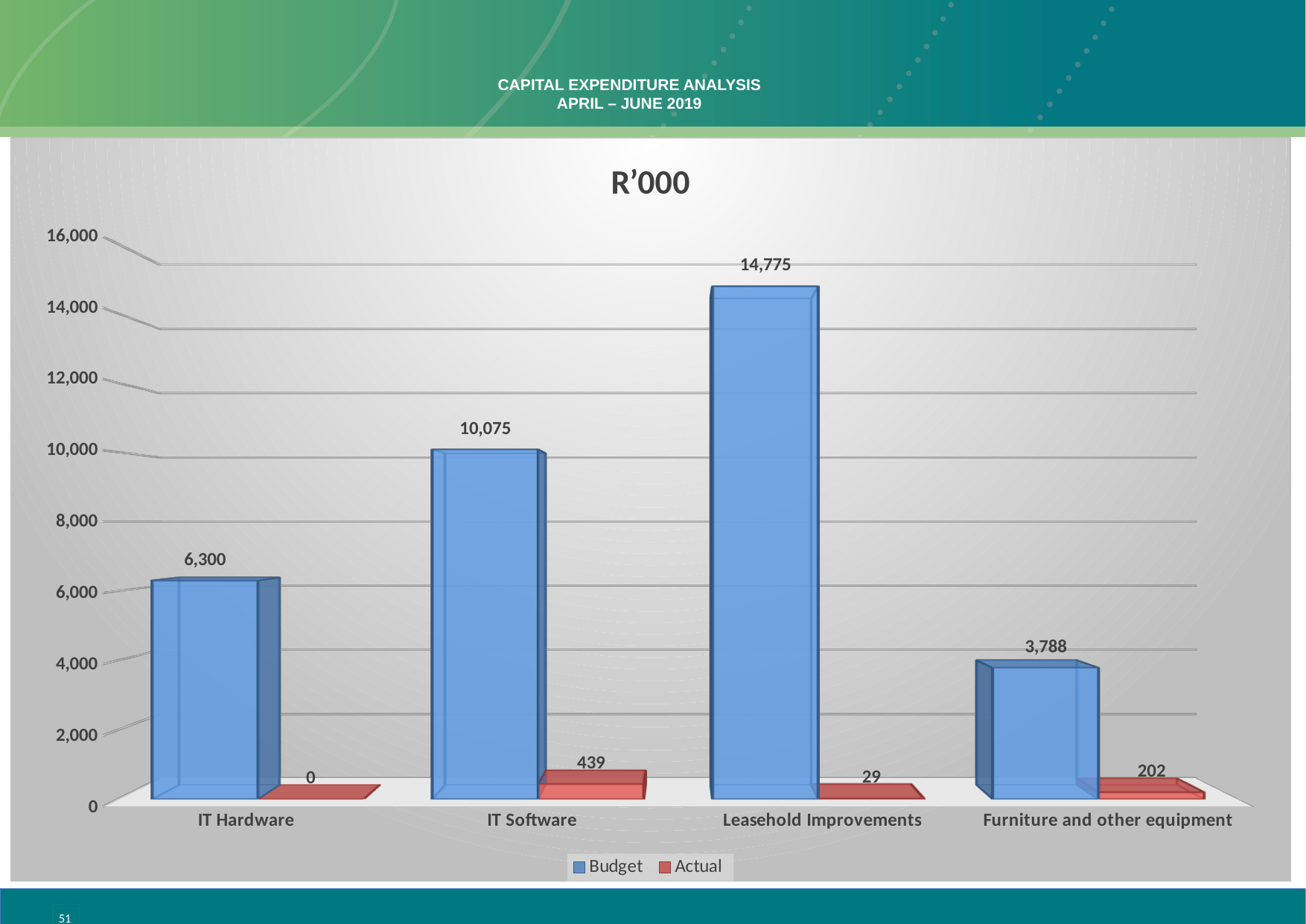
What is the difference between the Budget and Actual values for Leasehold Improvements? 14,746 How many series does the legend list? 2 What is the Actual value for IT Hardware? 0 Is the Budget value for IT Software greater or less than 8,000? greater What is the Budget value for IT Software? 10,075 Which category has the lowest Budget value? Furniture and other equipment How many categories are shown on the x axis? 4 What type of chart is shown on the slide? Bar chart Which is larger, the Budget value for IT Hardware or the Budget value for Furniture and other equipment? IT Hardware Which category has the highest Budget value? Leasehold Improvements Which category has the highest Actual value? IT Software What is the Actual value for Furniture and other equipment? 202